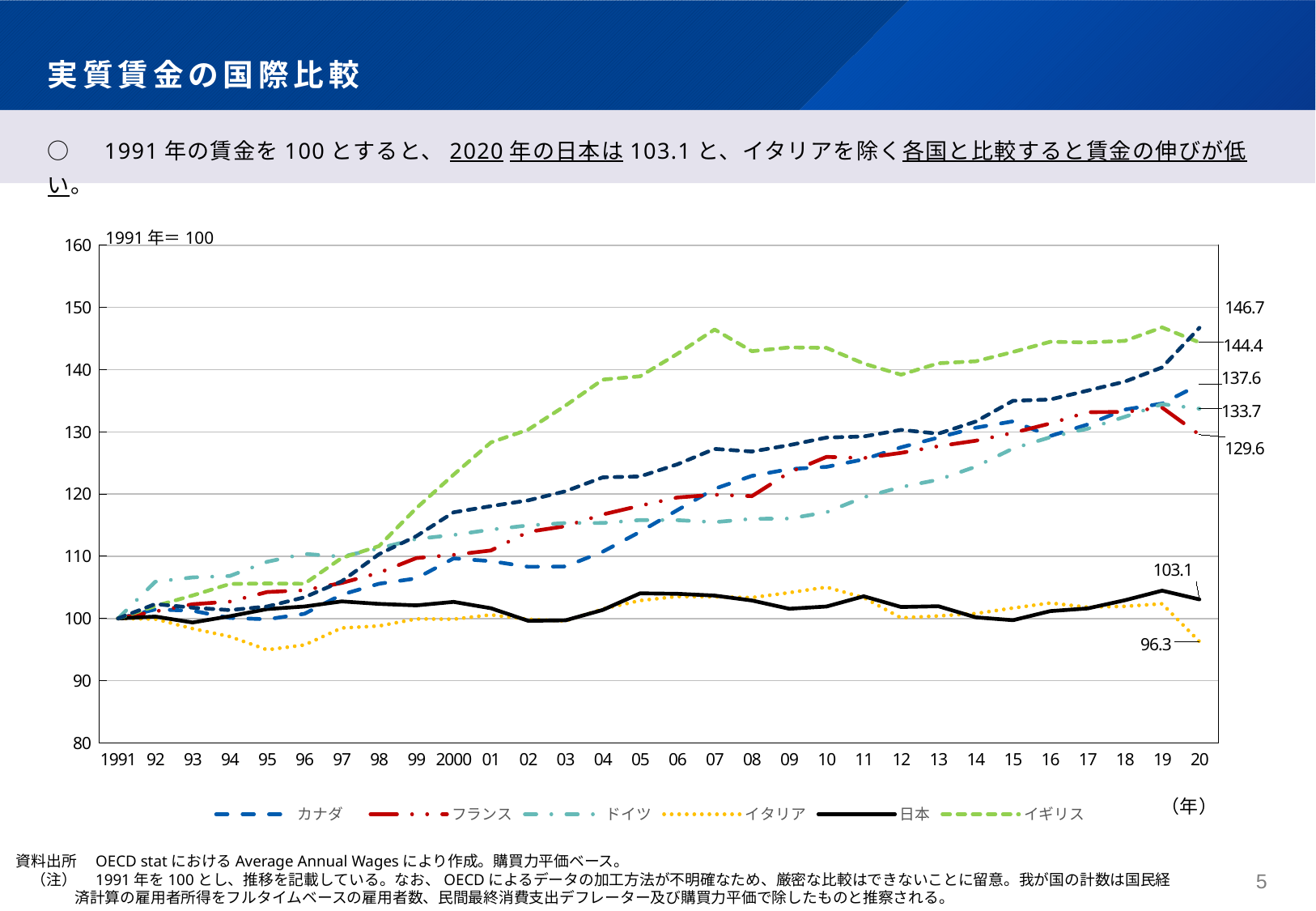
What is the difference between the 2020 values for 日本 (103.1) and イタリア (96.3)? 6.8 How many series does the legend list? 6 What is the value for フランス (France) in 2020? 129.6 Is the value for 日本 in 2020 greater or less than 110? less Which is larger in 2020, the value for 日本 or the value for イタリア? 日本 What is the value for イタリア (Italy) in 2020? 96.3 Does the イギリス (UK) line generally rise or fall from 1991 to 2020? Rise What is the value for イギリス (UK) in 2020? 144.4 What is the value for ドイツ (Germany) in 2020? 133.7 What kind of chart is shown on the slide? Line chart What is the value for 日本 (Japan) in 2020? 103.1 Which country has the lowest value in 2020? イタリア